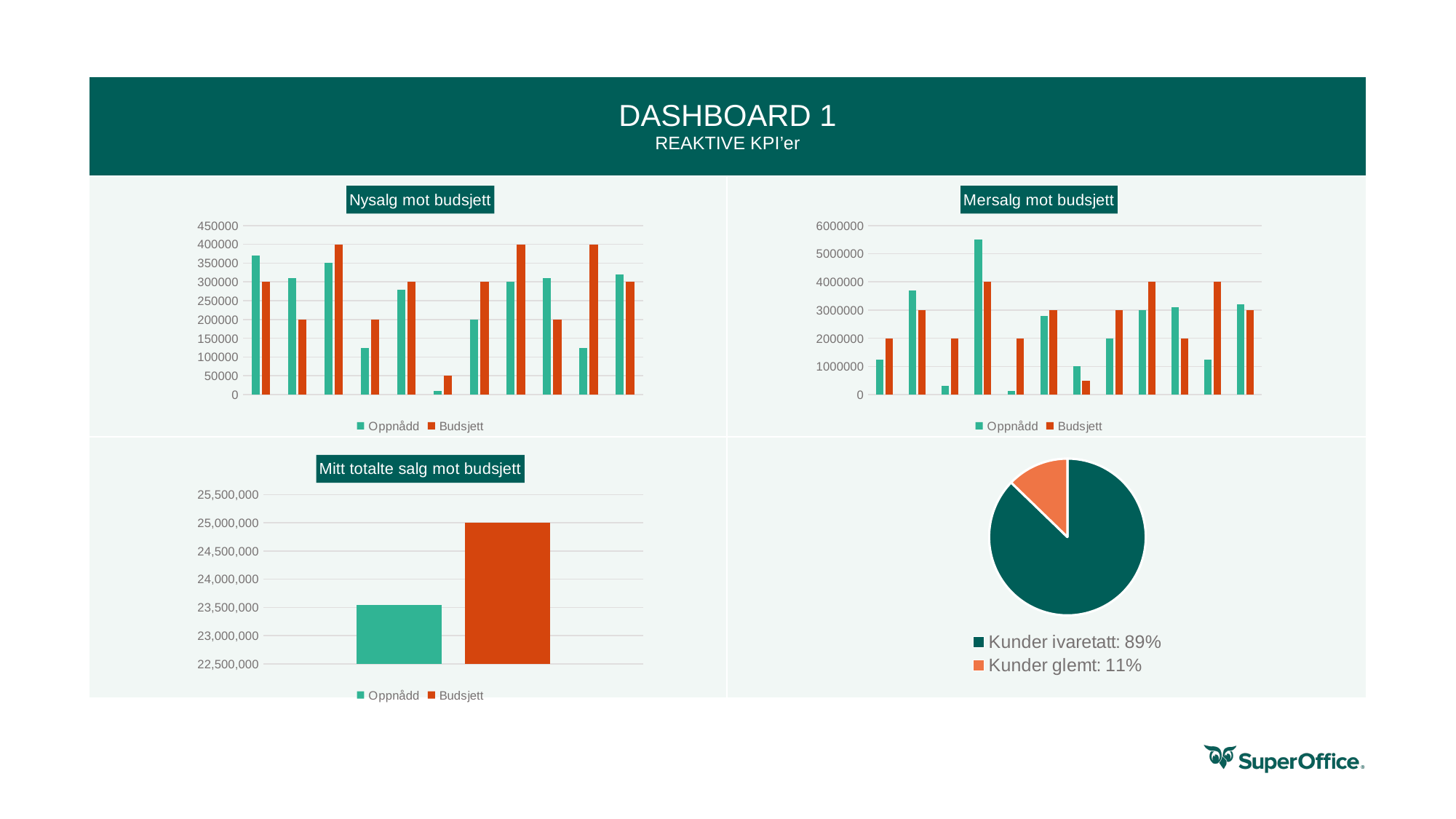
In the pie chart at the bottom right, which slice is larger, Kunder ivaretatt or Kunder glemt? Kunder ivaretatt What kind of chart is 'Mitt totalte salg mot budsjett'? bar chart In the pie chart at the bottom right, what share is Kunder ivaretatt? 89% In the chart 'Nysalg mot budsjett', is the tallest Oppnådd bar greater or less than 350000? greater In the pie chart at the bottom right, what share is Kunder glemt? 11% In the chart 'Mersalg mot budsjett', is the tallest Oppnådd bar greater or less than 5000000? greater How many slices does the pie chart at the bottom right have? 2 In the chart 'Mitt totalte salg mot budsjett', is the value for Oppnådd greater or less than 24,000,000? less In the chart 'Mitt totalte salg mot budsjett', what is the value for Budsjett? 25,000,000 How many series does the legend of the chart 'Nysalg mot budsjett' list? 2 In the chart 'Mitt totalte salg mot budsjett', which is larger, Oppnådd or Budsjett? Budsjett What are the two legend entries of the chart 'Mersalg mot budsjett'? Oppnådd and Budsjett